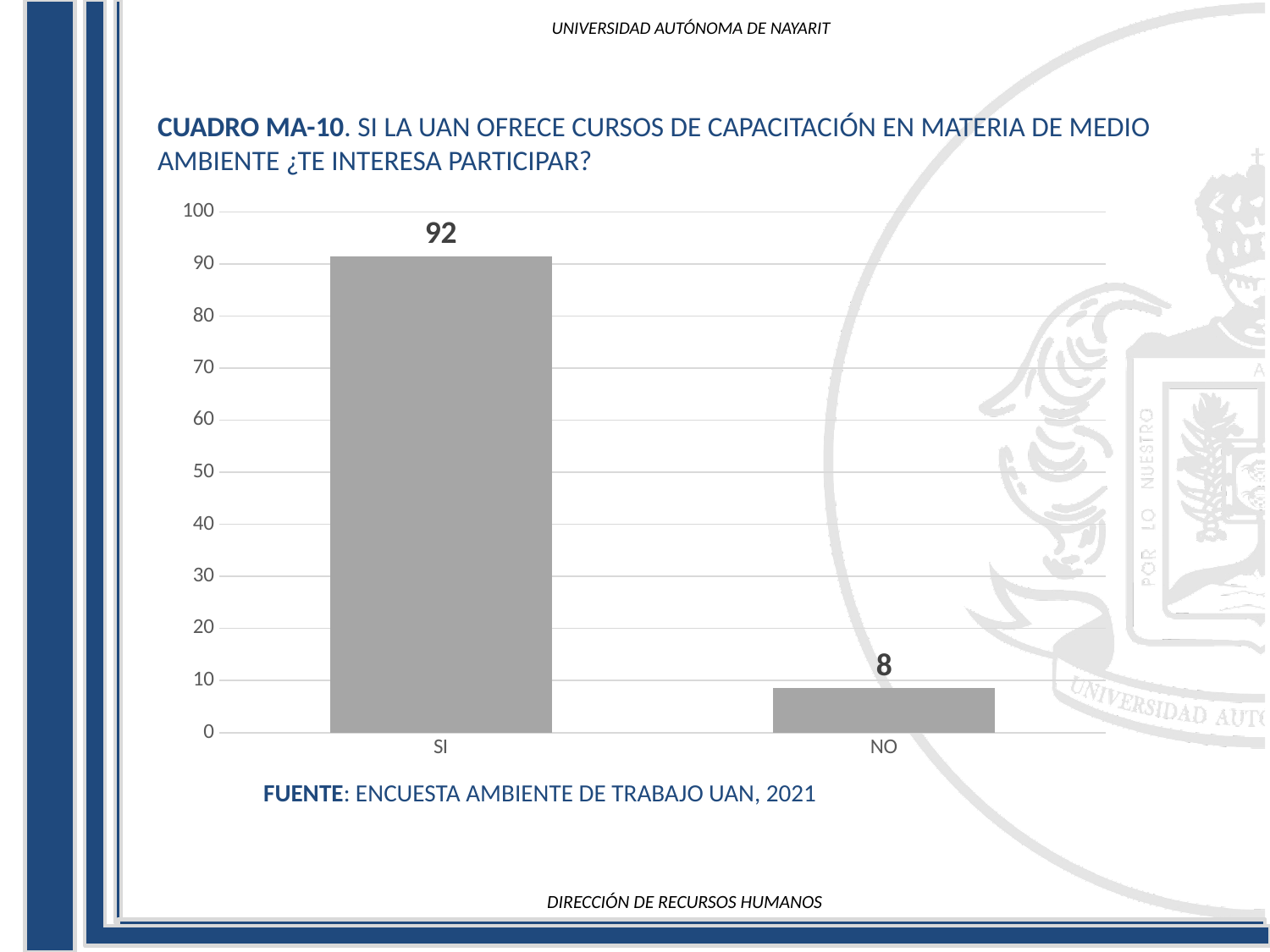
Which category has the highest value? SI What is the value for SI? 92 What is the value for NO? 8 What is the total of the values for SI and NO? 100 Is the value for SI greater or less than 50? greater Which category has the lowest value? NO What kind of chart is shown on the slide? bar chart What is the difference between the values for SI and NO? 84 Is the value for NO greater or less than 20? less Which is larger, the value for SI or the value for NO? SI What source is cited below the chart? ENCUESTA AMBIENTE DE TRABAJO UAN, 2021 How many categories are shown on the x axis? 2